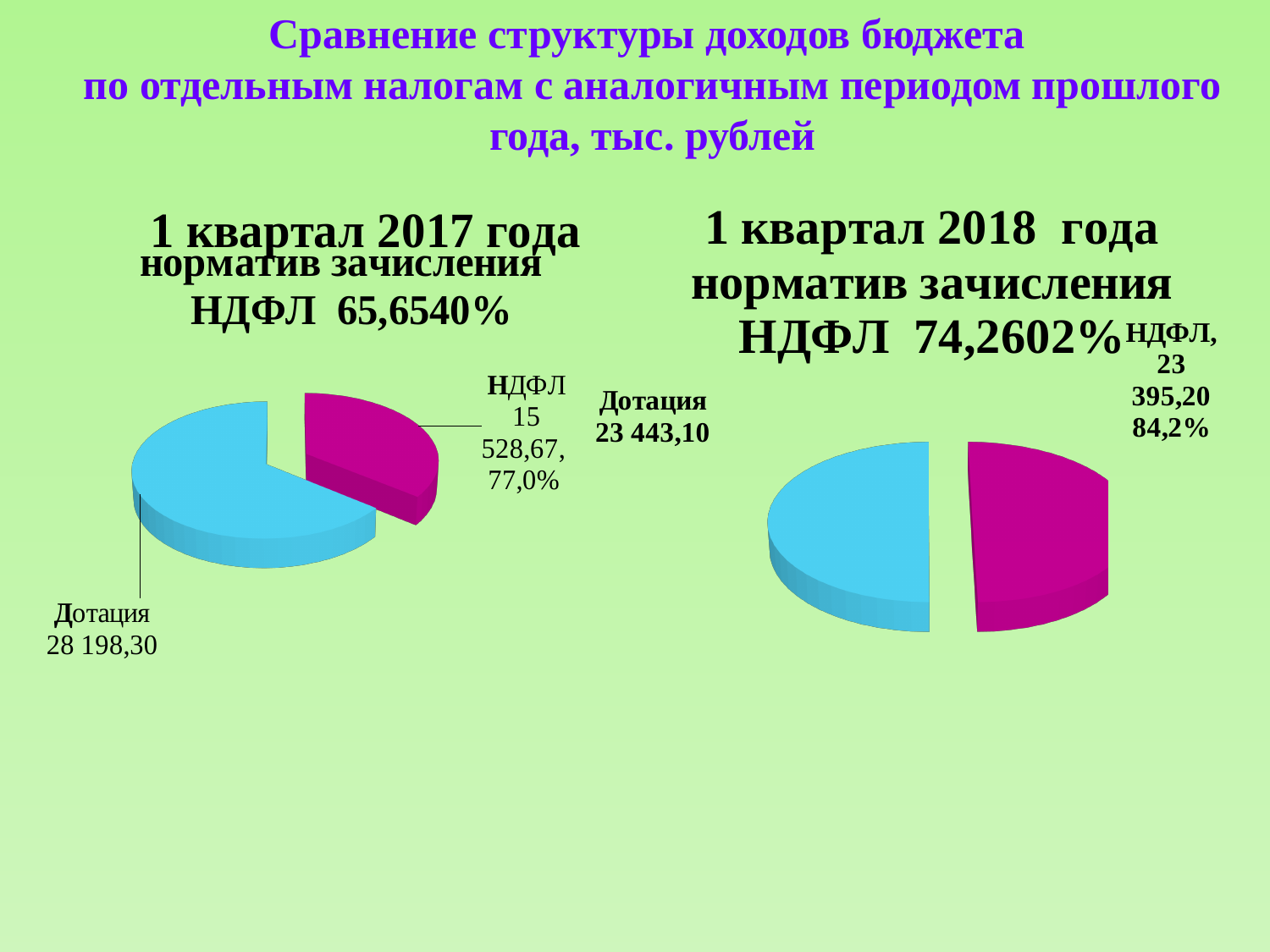
In the left chart (1 квартал 2017 года), what percentage is printed on the НДФЛ slice label? 77,0% In the right chart (1 квартал 2018 года), what is the value for Дотация? 23 443,10 In the left chart (1 квартал 2017 года), what is the value for Дотация? 28 198,30 In the left chart (1 квартал 2017 года), what is the value for НДФЛ? 15 528,67 How many slices does the left chart (1 квартал 2017 года) have? 2 In the right chart (1 квартал 2018 года), what percentage is printed on the НДФЛ slice label? 84,2% In the right chart (1 квартал 2018 года), what is the difference between Дотация and НДФЛ? 47,90 What НДФЛ норматив зачисления is stated above the right chart (1 квартал 2018 года)? 74,2602% In the left chart (1 квартал 2017 года), what is the difference between Дотация and НДФЛ? 12 669,63 In the left chart (1 квартал 2017 года), which is larger, Дотация or НДФЛ? Дотация What kind of chart is the left chart (1 квартал 2017 года)? pie chart In the right chart (1 квартал 2018 года), what is the value for НДФЛ? 23 395,20